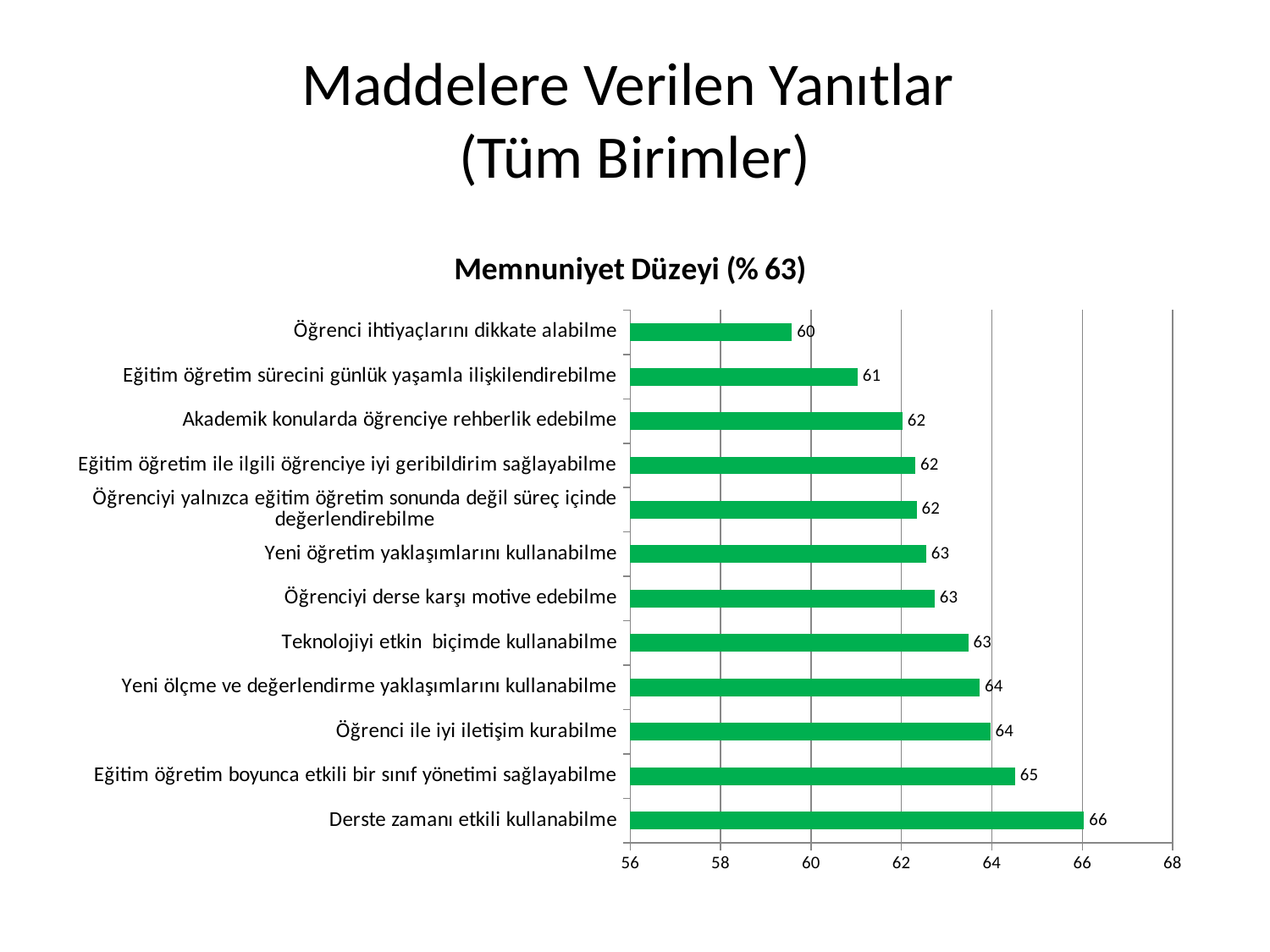
Which category has the lowest value? Öğrenci ihtiyaçlarını dikkate alabilme What kind of chart is shown on the slide? bar chart Which is larger: the value for "Eğitim öğretim boyunca etkili bir sınıf yönetimi sağlayabilme" or the value for "Eğitim öğretim sürecini günlük yaşamla ilişkilendirebilme"? Eğitim öğretim boyunca etkili bir sınıf yönetimi sağlayabilme How many categories are shown in the chart? 12 What is the value for "Derste zamanı etkili kullanabilme"? 66 What is the value for "Öğrenci ihtiyaçlarını dikkate alabilme"? 60 What is the title of the chart? Memnuniyet Düzeyi (% 63) Is the value for "Öğrenci ile iyi iletişim kurabilme" greater or less than 62? greater What is the value for "Eğitim öğretim boyunca etkili bir sınıf yönetimi sağlayabilme"? 65 What is the difference between the values for "Derste zamanı etkili kullanabilme" and "Öğrenci ihtiyaçlarını dikkate alabilme"? 6 Which category has the highest value? Derste zamanı etkili kullanabilme What is the value for "Eğitim öğretim sürecini günlük yaşamla ilişkilendirebilme"? 61